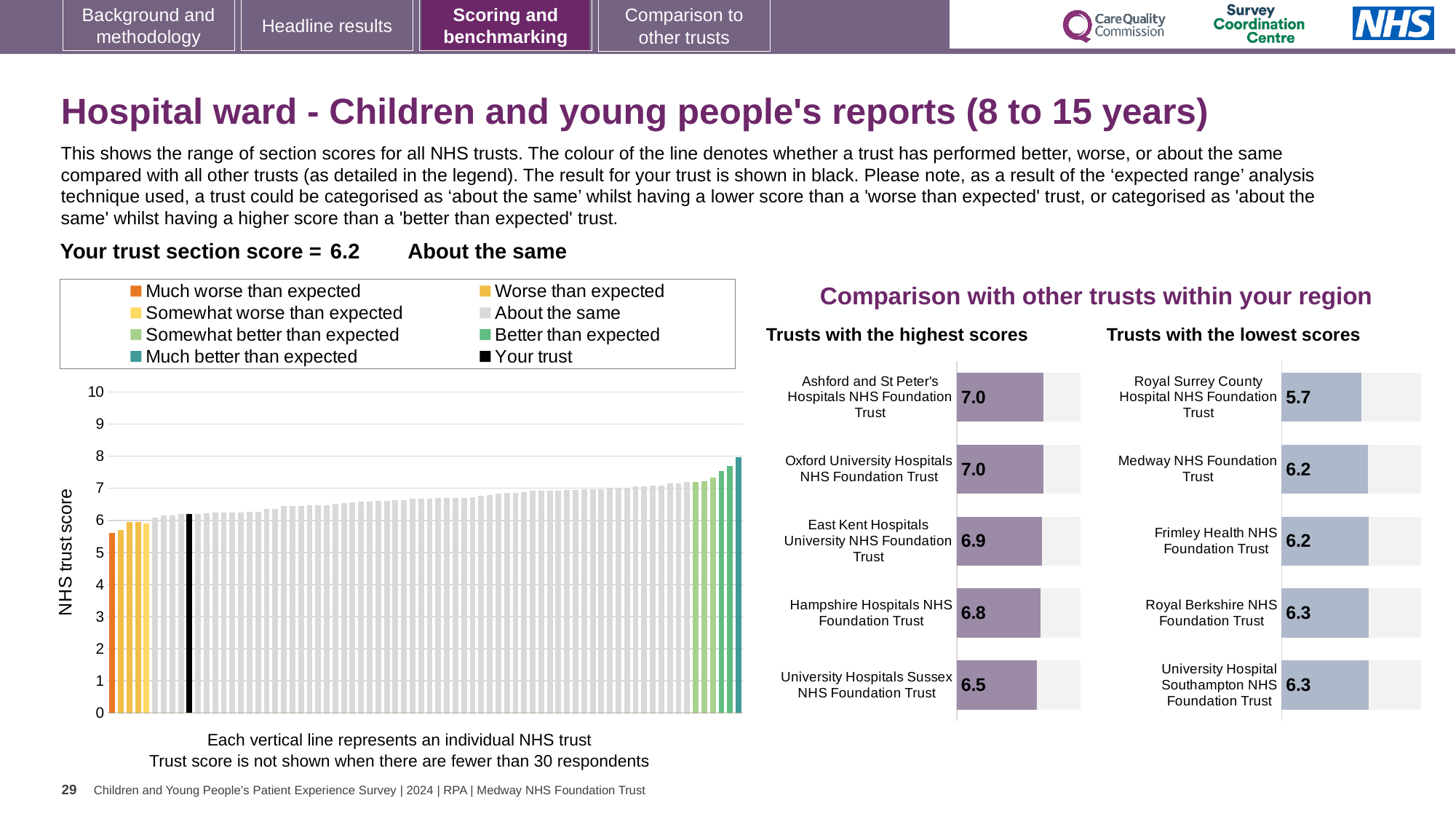
In the 'Trusts with the highest scores' chart, which has the higher score: East Kent Hospitals University NHS Foundation Trust or Hampshire Hospitals NHS Foundation Trust? East Kent Hospitals University NHS Foundation Trust In the 'Trusts with the lowest scores' chart, what is the difference between the scores of Royal Berkshire NHS Foundation Trust and Royal Surrey County Hospital NHS Foundation Trust? 0.6 What kind of chart is the large 'NHS trust score' chart on the left of the slide? Bar chart How many entries does the legend of the 'NHS trust score' chart list? 8 In the 'Trusts with the highest scores' chart, which trust has the lowest score? University Hospitals Sussex NHS Foundation Trust In the 'NHS trust score' chart, what is the section score for your trust (the black bar)? 6.2 In the 'Trusts with the highest scores' chart, what is the difference between the scores of Ashford and St Peter's Hospitals NHS Foundation Trust and University Hospitals Sussex NHS Foundation Trust? 0.5 In the 'Trusts with the highest scores' chart, what is the score for Ashford and St Peter's Hospitals NHS Foundation Trust? 7.0 In the 'Trusts with the lowest scores' chart, what is the score for Royal Surrey County Hospital NHS Foundation Trust? 5.7 In the 'Trusts with the lowest scores' chart, which trust has the lowest score? Royal Surrey County Hospital NHS Foundation Trust In the 'Trusts with the highest scores' chart, what is the score for Hampshire Hospitals NHS Foundation Trust? 6.8 How many trusts are shown in the 'Trusts with the lowest scores' chart? 5